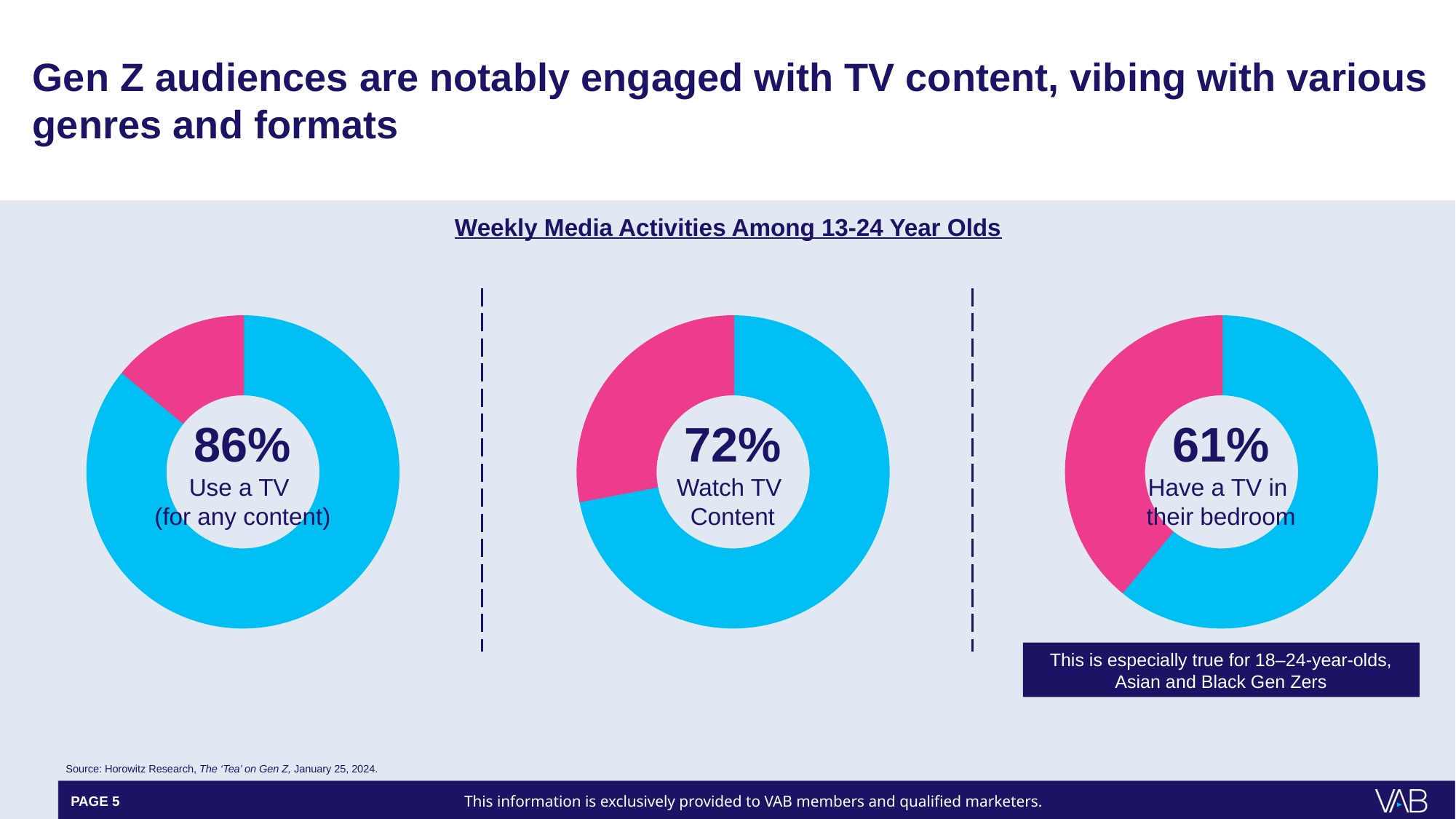
What is the difference in percentage points between the 'Watch TV Content' chart and the 'Have a TV in their bedroom' chart? 11 Which of the three donut charts shows the lowest percentage? Have a TV in their bedroom What is the title above the three donut charts? Weekly Media Activities Among 13-24 Year Olds According to the right donut chart, what percentage of 13-24 year olds have a TV in their bedroom? 61% What kind of chart is used to show each of the three statistics on the slide? Donut (pie) chart Which of the three donut charts shows the highest percentage? Use a TV (for any content) In the middle donut chart, what percentage of 13-24 year olds watch TV content weekly? 72% How many donut charts are shown on the slide? 3 Which is larger: the percentage who watch TV content or the percentage who have a TV in their bedroom? Watch TV Content In the left donut chart, what share of the ring is taken up by the blue segment? 86% What percentage of 13-24 year olds use a TV (for any content) weekly, according to the left donut chart? 86% What is the difference in percentage points between the 'Use a TV (for any content)' chart and the 'Watch TV Content' chart? 14